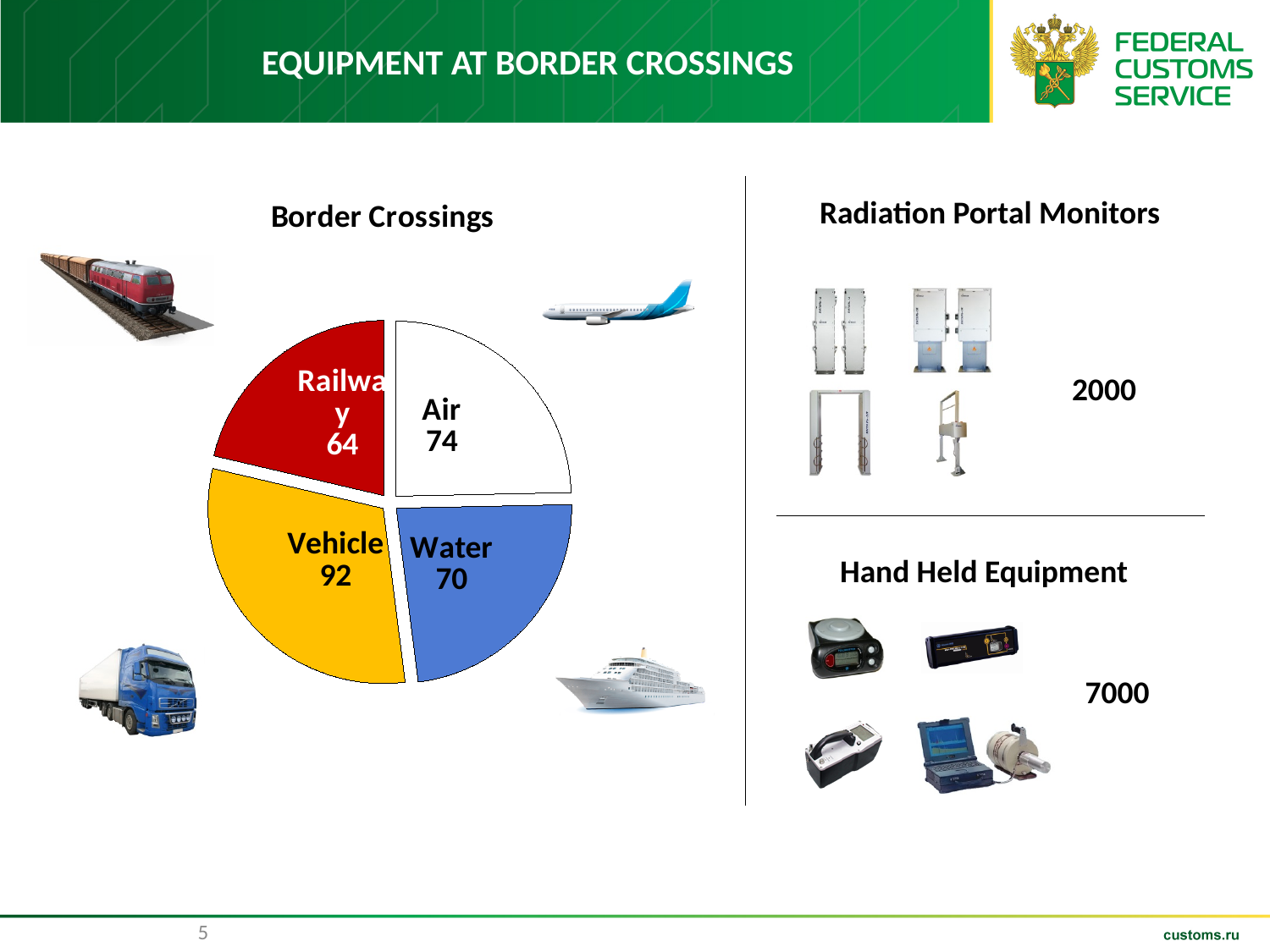
In the Border Crossings pie chart, which category has the largest value? Vehicle In the Border Crossings pie chart, which category has the smallest value? Railway In the Border Crossings pie chart, which is larger, Air or Water? Air In the Border Crossings pie chart, what is the value for Water? 70 In the Border Crossings pie chart, what colour is the Vehicle slice? Yellow In the Border Crossings pie chart, what is the total of all four slice values? 300 How many slices does the Border Crossings pie chart have? 4 In the Border Crossings pie chart, what is the difference between the Vehicle and Railway values? 28 In the Border Crossings pie chart, what is the value for Vehicle? 92 What type of chart is shown under the title "Border Crossings"? Pie chart In the Border Crossings pie chart, what is the value for Railway? 64 In the Border Crossings pie chart, what is the value for Air? 74